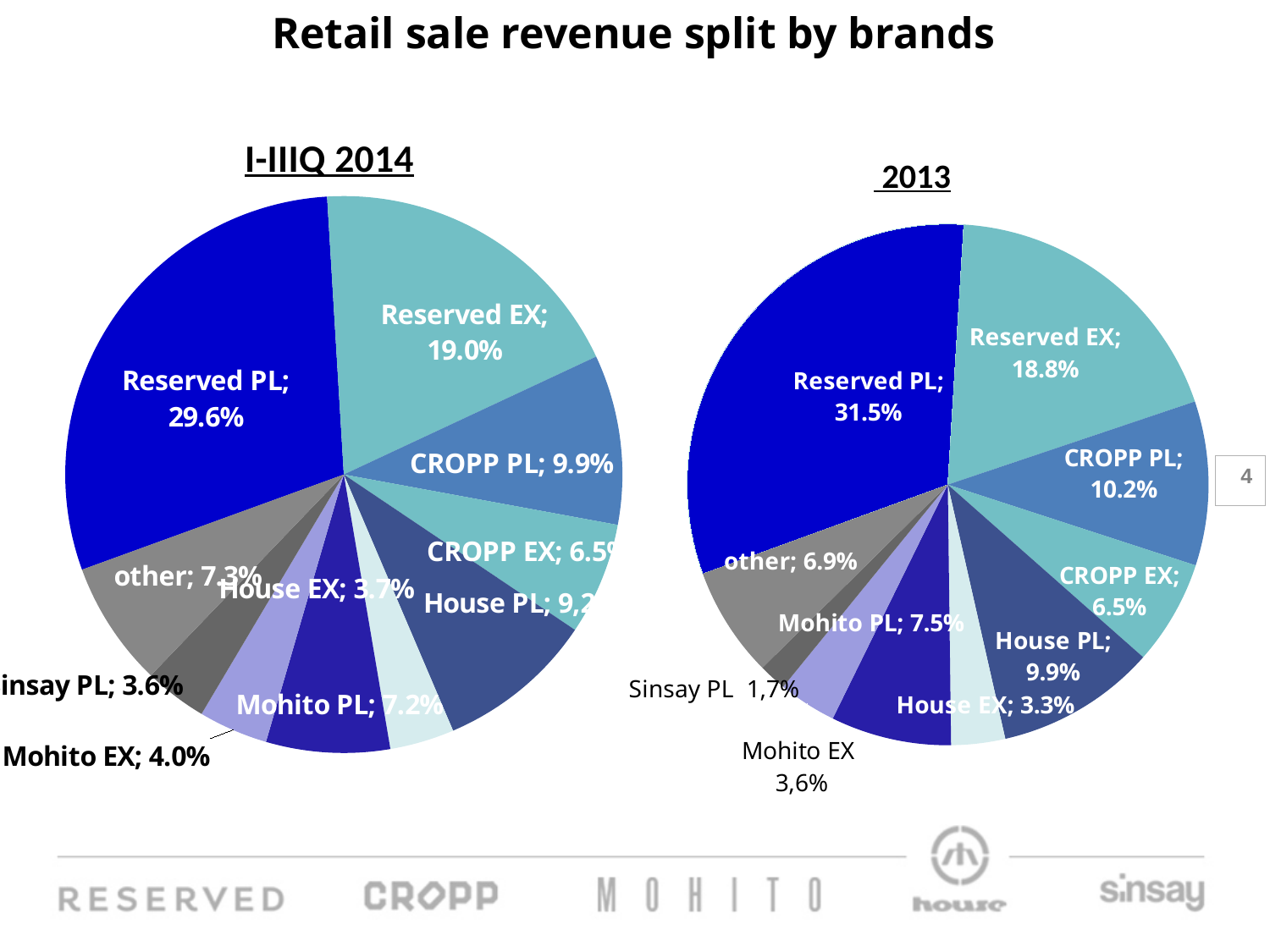
In the I-IIIQ 2014 pie chart, which brand has the largest share? Reserved PL In the 2013 pie chart, what is the value for CROPP PL? 10.2% In the 2013 pie chart, which brand has the smallest share? Sinsay PL How many slices does the 2013 pie chart have? 10 In the I-IIIQ 2014 pie chart, what share does Reserved PL have? 29.6% In the 2013 pie chart, what share does Sinsay PL have? 1,7% In the 2013 pie chart, what share does Reserved EX have? 18.8% In the 2013 pie chart, what is the difference between Reserved PL and Reserved EX? 12.7% In the I-IIIQ 2014 pie chart, what is the value for Mohito PL? 7.2% In the 2013 pie chart, is the share for House PL larger or smaller than the share for Mohito PL? larger Which is larger in the I-IIIQ 2014 pie chart: Mohito EX or House EX? Mohito EX What type of chart is used on this slide? Pie chart